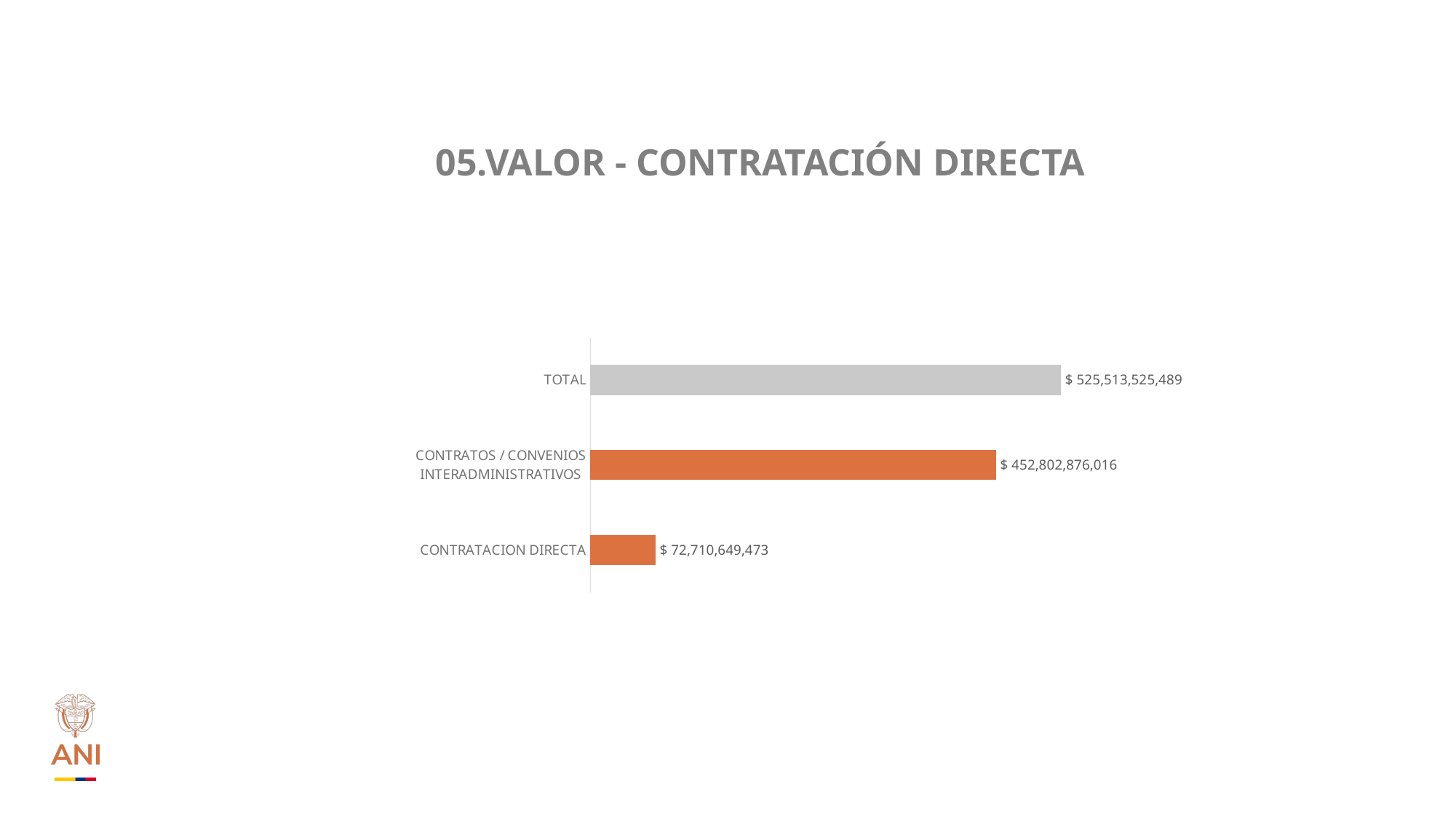
What is the value shown for TOTAL? $ 525,513,525,489 What is the difference between the TOTAL value and the CONTRATOS / CONVENIOS INTERADMINISTRATIVOS value? $ 72,710,649,473 Which category has the lowest value? CONTRATACION DIRECTA How many categories are shown in the chart? 3 What colour is the TOTAL bar? Grey What is the value shown for CONTRATOS / CONVENIOS INTERADMINISTRATIVOS? $ 452,802,876,016 What is the value shown for CONTRATACION DIRECTA? $ 72,710,649,473 Which is larger, the value for CONTRATOS / CONVENIOS INTERADMINISTRATIVOS or the value for CONTRATACION DIRECTA? CONTRATOS / CONVENIOS INTERADMINISTRATIVOS Which category has the highest value? TOTAL What is the title of the slide? 05.VALOR - CONTRATACIÓN DIRECTA What is the difference between the CONTRATOS / CONVENIOS INTERADMINISTRATIVOS value and the CONTRATACION DIRECTA value? $ 380,092,226,543 What kind of chart is shown on the slide? Bar chart